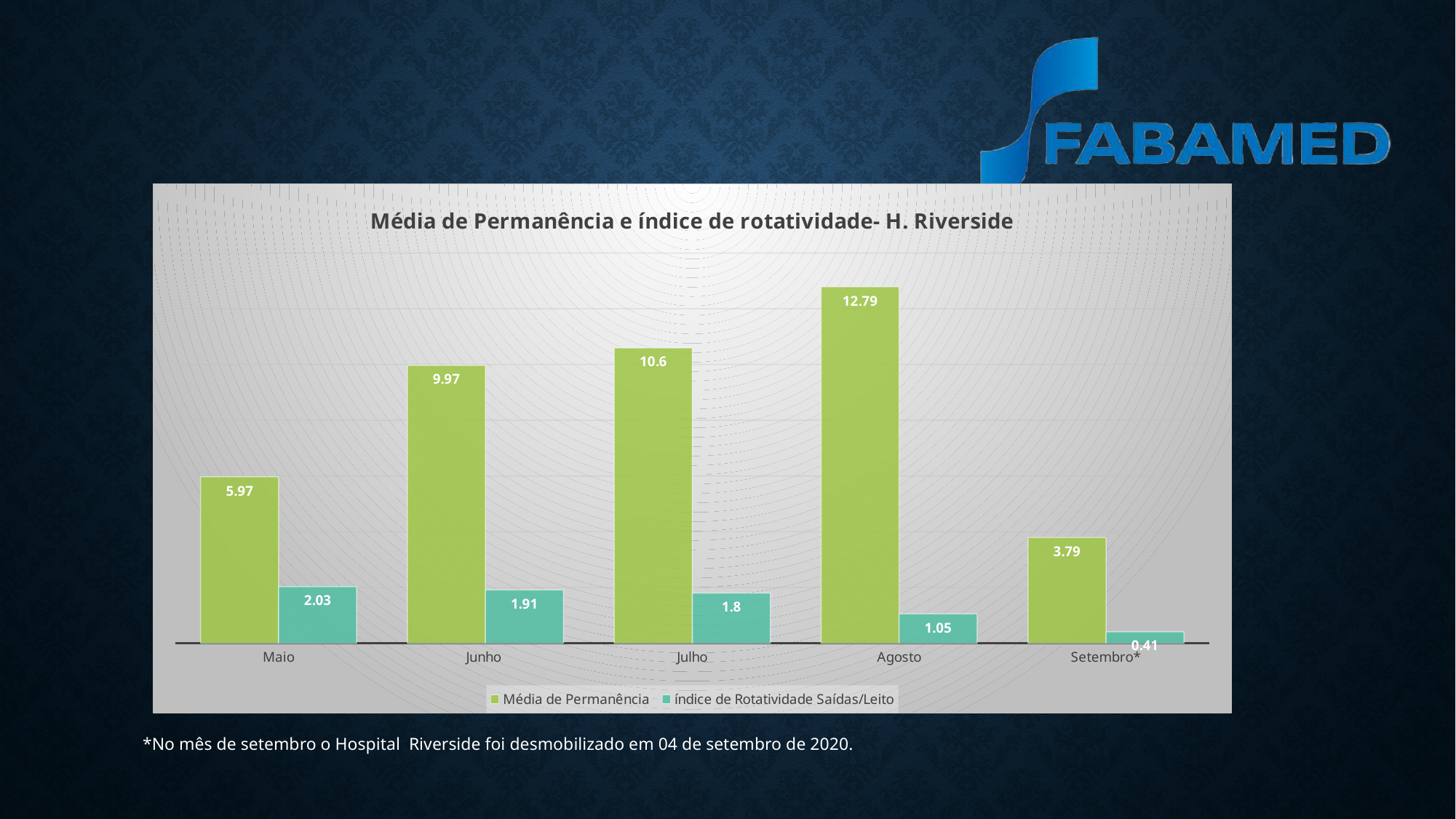
What is the Média de Permanência value for Setembro*? 3.79 What is the índice de Rotatividade Saídas/Leito value for Maio? 2.03 What is the Média de Permanência value for Agosto? 12.79 How many series does the legend list? 2 Which month has the lowest índice de Rotatividade Saídas/Leito? Setembro* Does the índice de Rotatividade Saídas/Leito rise or fall from Maio to Setembro*? Fall What is the title of the chart? Média de Permanência e índice de rotatividade- H. Riverside What is the difference between the Média de Permanência for Agosto and for Julho? 2.19 What kind of chart is shown on the slide? Bar chart Which is larger: the Média de Permanência for Junho or for Julho? Julho How many months are shown on the x axis? 5 Which month has the highest Média de Permanência? Agosto